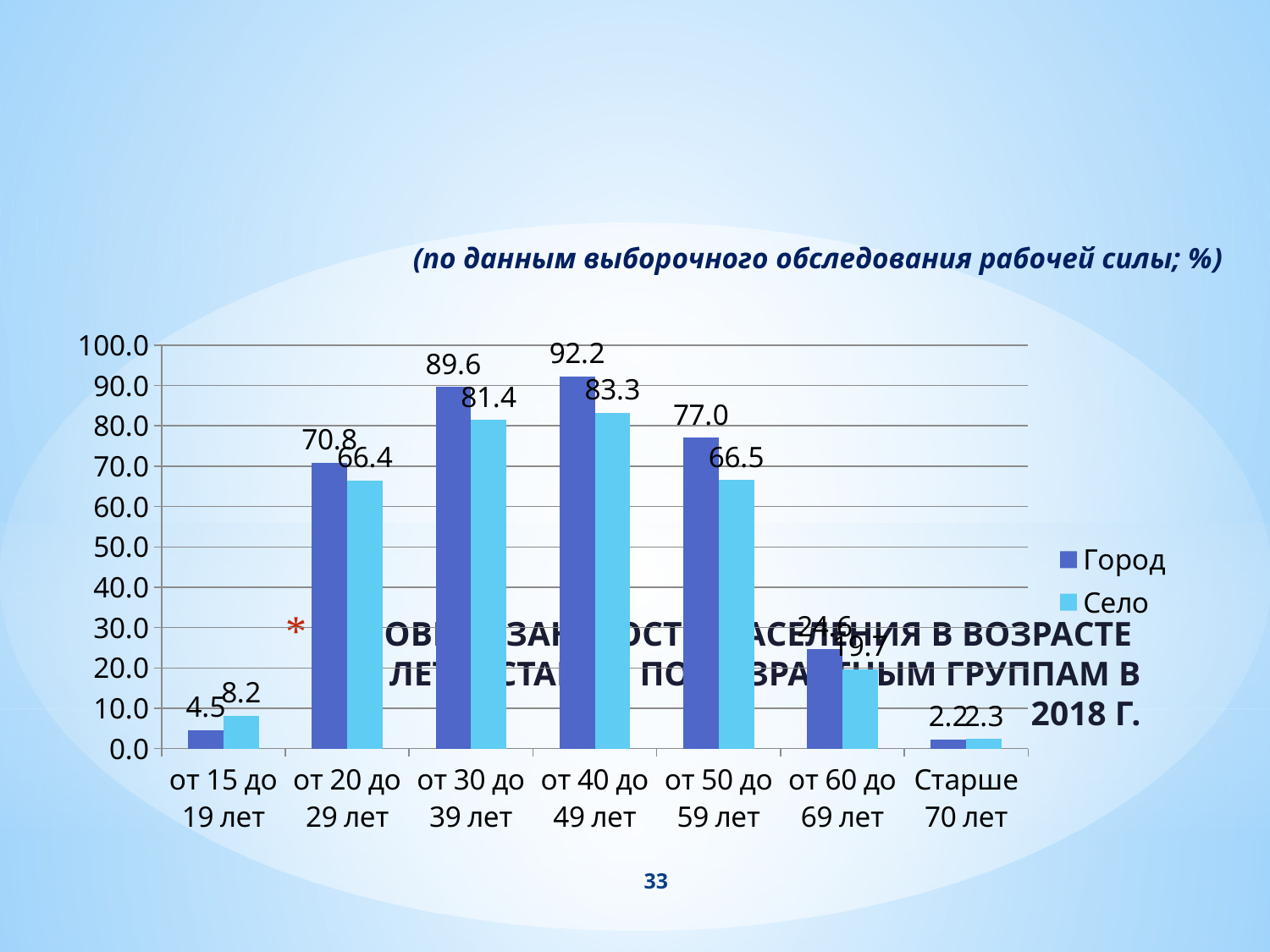
Which legend entry is shown in light blue? Село Which age group has the lowest value for Село? Старше 70 лет Is the value for Село in the age group от 60 до 69 лет greater or less than 30? less Which age group has the highest value for Город? от 40 до 49 лет What is the value for Село in the age group от 15 до 19 лет? 8.2 How many series does the legend list? 2 What is the value for Село in the age group от 30 до 39 лет? 81.4 In the age group от 20 до 29 лет, which is larger: Город or Село? Город What type of chart is shown on the slide? bar chart How many age-group categories are shown on the x axis? 7 What is the value for Город in the age group от 40 до 49 лет? 92.2 What is the difference between the Город and Село values in the age group от 50 до 59 лет? 10.5